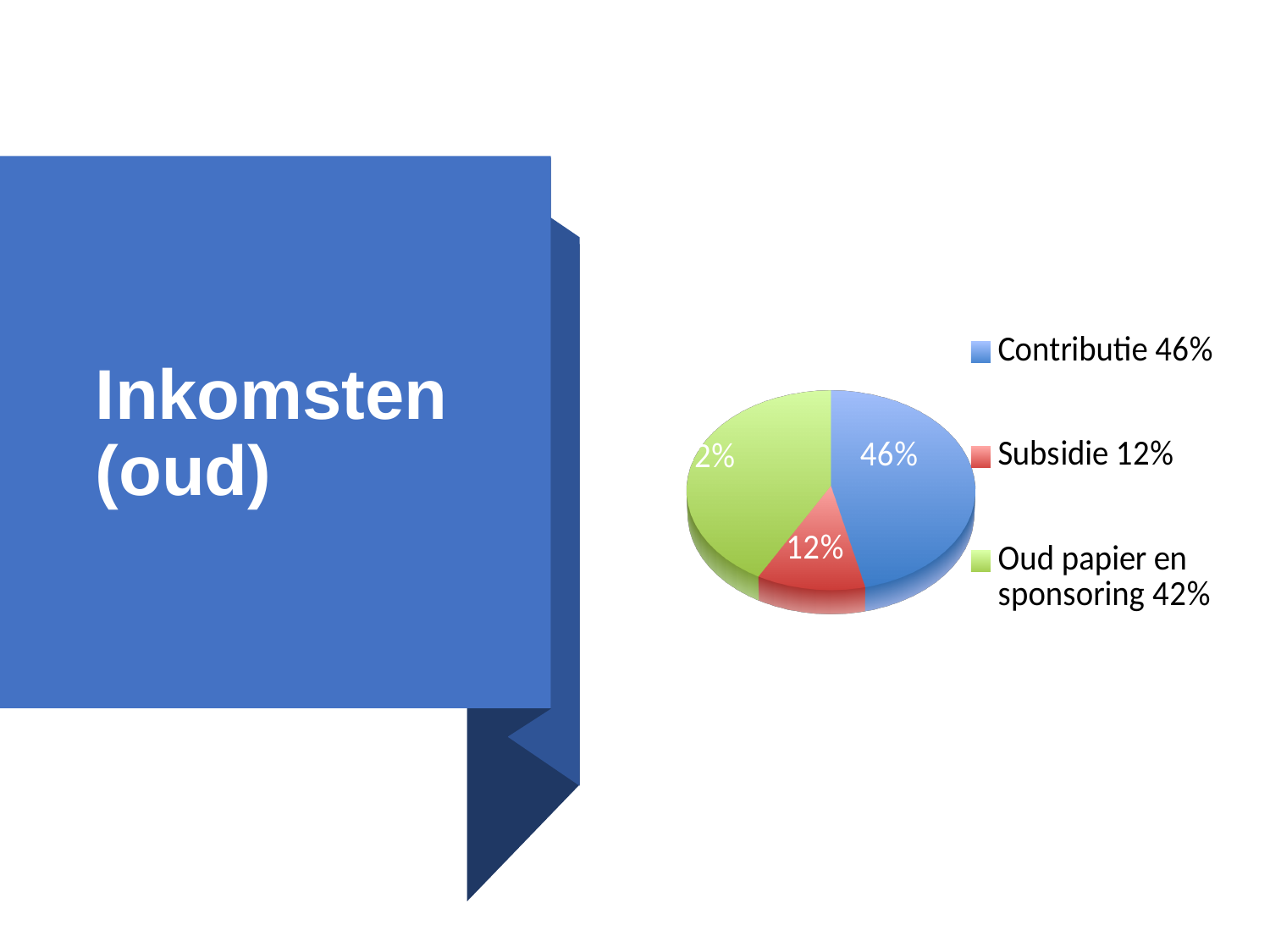
Which is larger, the slice for Contributie or the slice for Subsidie? Contributie What is the difference in percentage points between the Contributie slice and the Oud papier en sponsoring slice? 4 How many slices does the pie chart have? 3 What share of the pie does Subsidie represent? 12% How many entries does the legend of the pie chart list? 3 What share of the pie does Contributie represent? 46% What share of the pie does Oud papier en sponsoring represent? 42% Which category has the smallest slice of the pie? Subsidie What is the difference in percentage points between the Contributie slice and the Subsidie slice? 34 What colour is the Subsidie slice in the pie chart? red Which category has the largest slice of the pie? Contributie What kind of chart is shown on the slide? pie chart